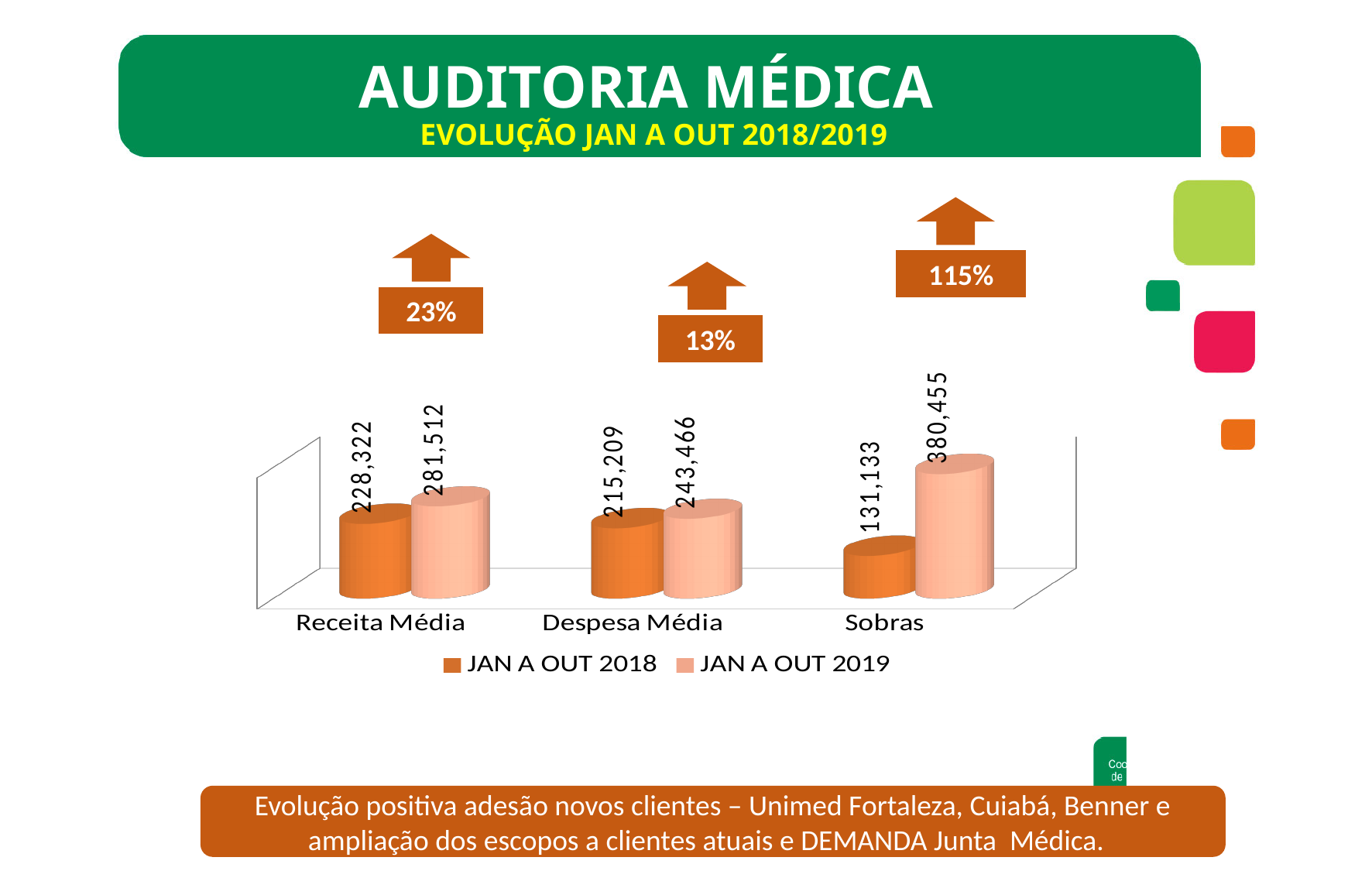
What is the value for Sobras in the JAN A OUT 2019 series? 380,455 What is the difference between the JAN A OUT 2019 and JAN A OUT 2018 values for Sobras? 249,322 How many categories are shown on the x axis of the chart? 3 Which is larger: the JAN A OUT 2018 value for Receita Média or the JAN A OUT 2018 value for Despesa Média? Receita Média What kind of chart is shown on the slide? Bar chart How many series does the chart legend list? 2 What is the value for Despesa Média in the JAN A OUT 2019 series? 243,466 Which category has the lowest value in the JAN A OUT 2018 series? Sobras What percentage increase is shown above the Sobras bars? 115% What is the difference between the JAN A OUT 2019 and JAN A OUT 2018 values for Receita Média? 53,190 Which category has the highest value in the JAN A OUT 2019 series? Sobras What is the value for Receita Média in the JAN A OUT 2018 series? 228,322